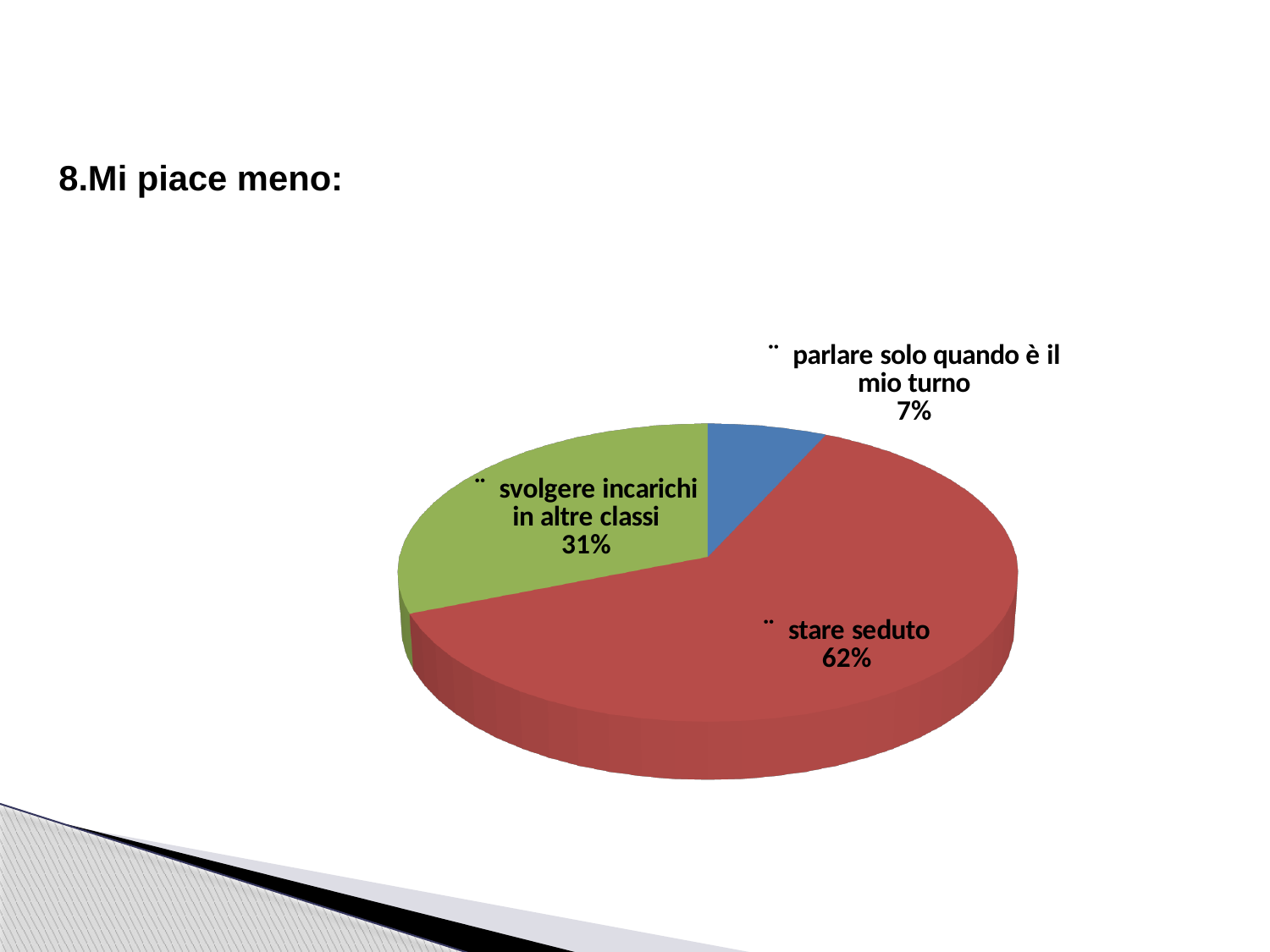
What share of the pie does 'parlare solo quando è il mio turno' represent? 7% What share of the pie does 'stare seduto' represent? 62% How many slices does the pie chart have? 3 What is the difference in percentage points between 'svolgere incarichi in altre classi' and 'parlare solo quando è il mio turno'? 24 What share of the pie does 'svolgere incarichi in altre classi' represent? 31% What kind of chart is shown on the slide? pie chart What is the title of the slide above the chart? 8.Mi piace meno: Which category has the largest slice of the pie? stare seduto What colour is the slice for 'stare seduto'? red Which category has the smallest slice of the pie? parlare solo quando è il mio turno Which is larger: the slice for 'svolgere incarichi in altre classi' or the slice for 'parlare solo quando è il mio turno'? svolgere incarichi in altre classi What is the difference in percentage points between 'stare seduto' and 'svolgere incarichi in altre classi'? 31